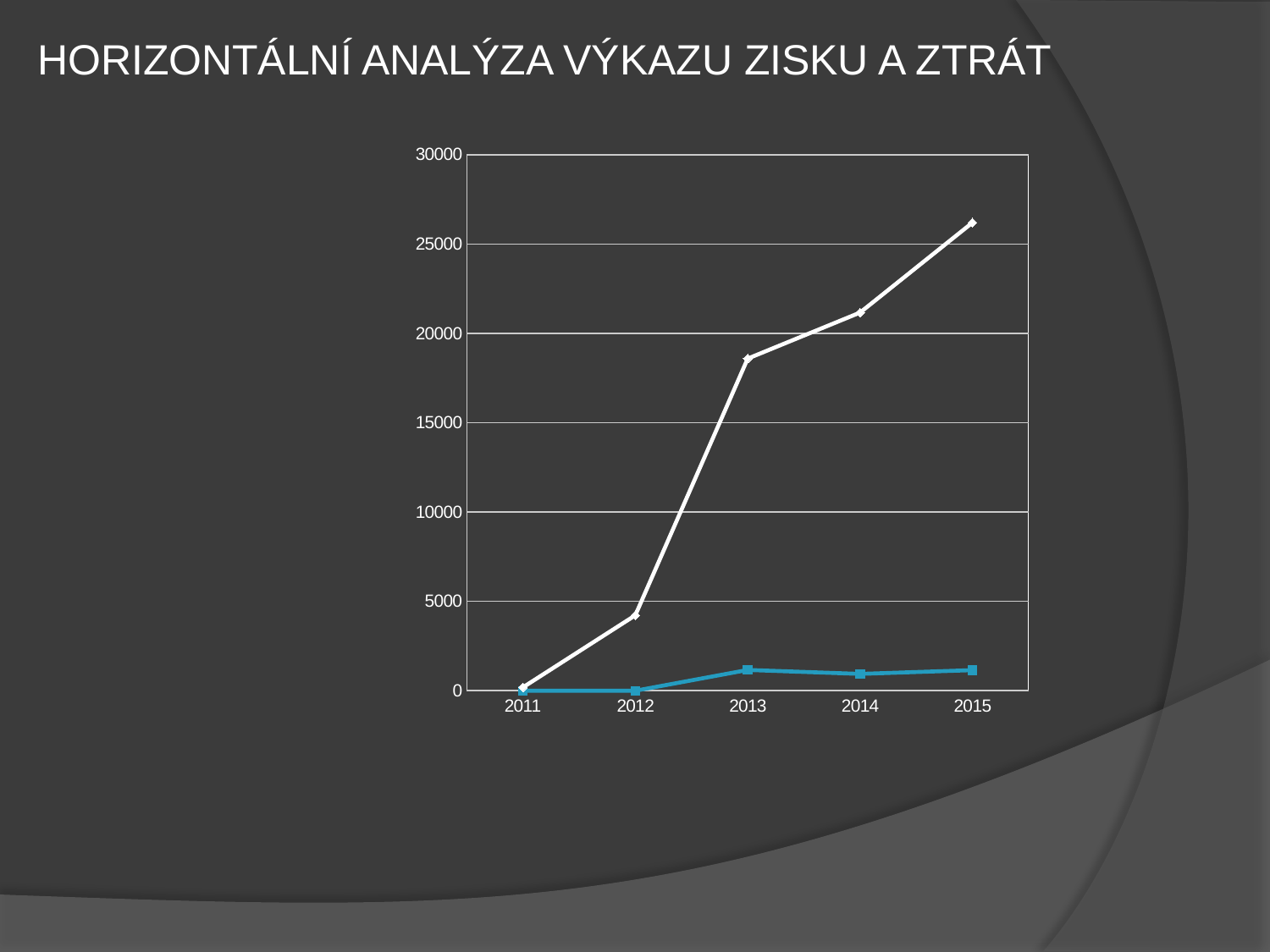
In 2015, which line has the larger value, the white line or the blue line? the white line How many years are shown on the x axis of the chart? 5 Is the value of the white line in 2013 greater or less than 20000? less Is the value of the white line in 2015 greater or less than 25000? greater In which year does the white line have its lowest value? 2011 What is the title of the slide containing the chart? HORIZONTÁLNÍ ANALÝZA VÝKAZU ZISKU A ZTRÁT Is the value of the white line in 2014 greater or less than 20000? greater In which year does the white line reach its highest value? 2015 Does the white line rise or fall from 2011 to 2015? rise What kind of chart is shown on the slide? line chart